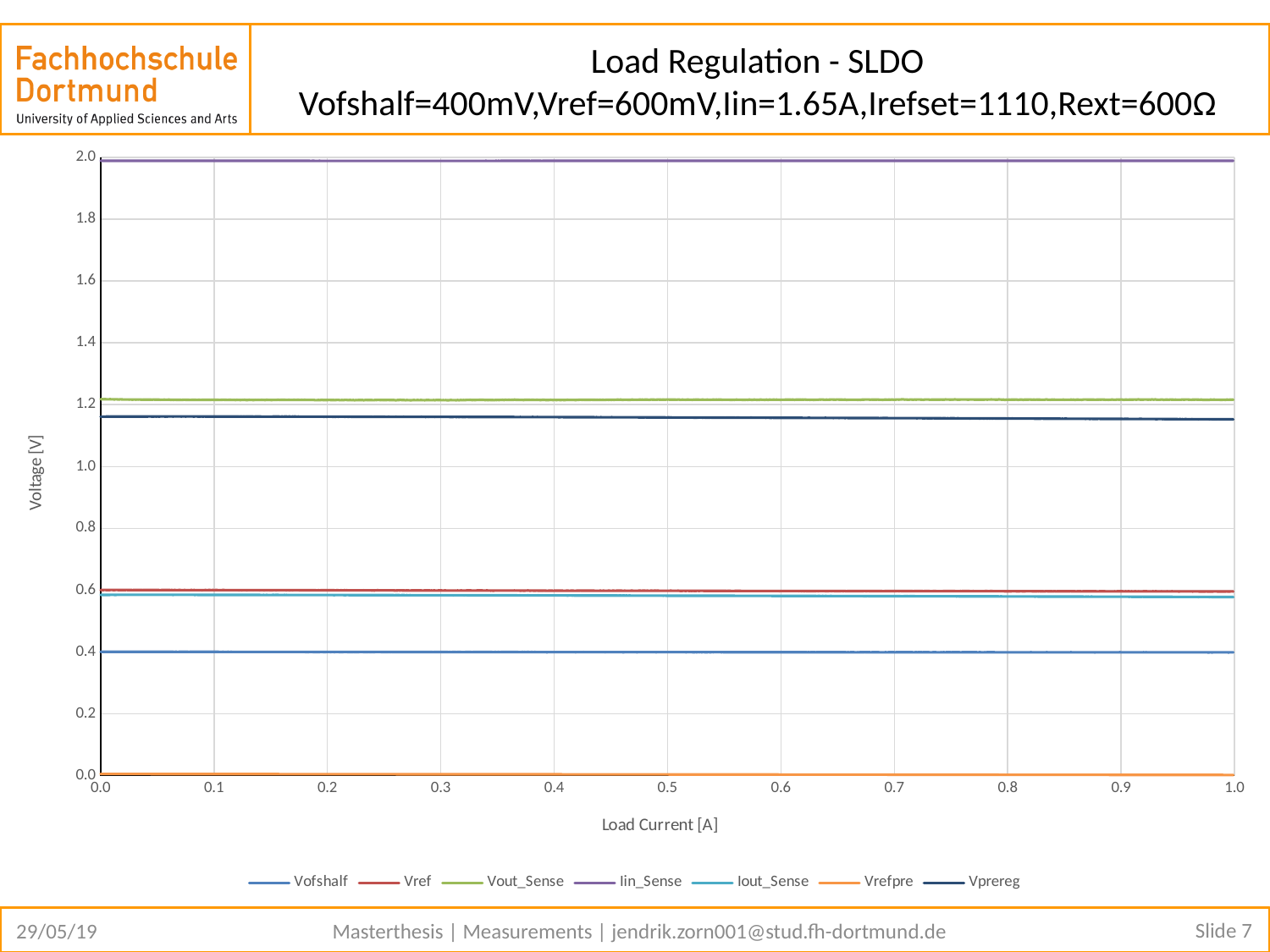
Which series is higher, Vref or Vofshalf? Vref What kind of chart is shown on the slide? line chart Is the value for Vout_Sense greater or less than 1.0? greater Is the value for Iin_Sense greater or less than 1.8? greater How many series does the legend list? 7 How does the Vofshalf voltage change as load current increases from 0.0 to 1.0 A? stays flat Which series has the lowest voltage across the load current range? Vrefpre Which series is higher, Vout_Sense or Vprereg? Vout_Sense Is the value for Vprereg greater or less than 1.4? less What is the label of the x axis? Load Current [A] Which series has the highest voltage across the load current range? Iin_Sense